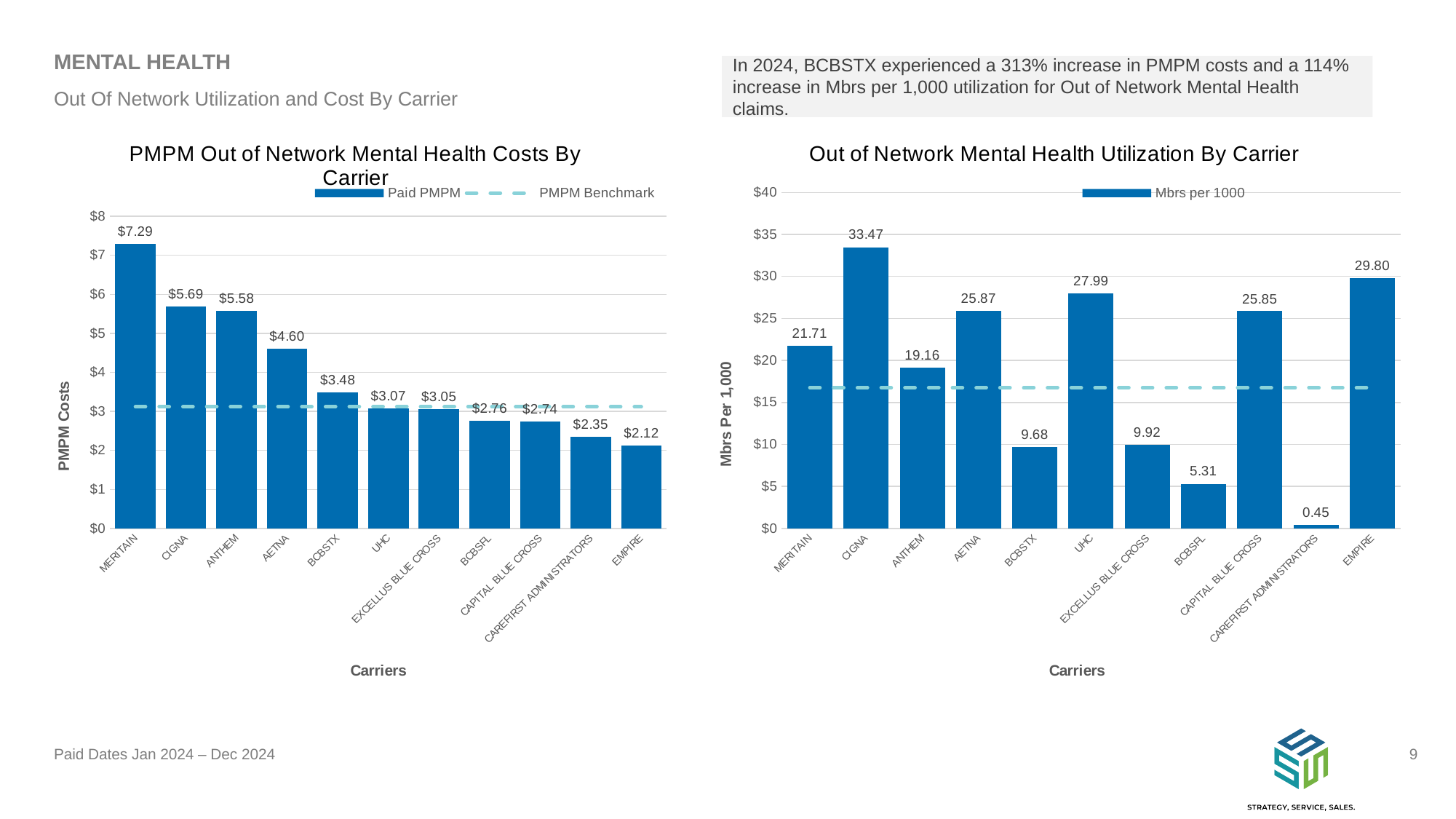
In the Out of Network Mental Health Utilization By Carrier chart, what is the Mbrs per 1000 value for UHC? 27.99 In the PMPM Out of Network Mental Health Costs By Carrier chart, what is the difference between the Paid PMPM for MERITAIN and CIGNA? $1.60 In the PMPM Out of Network Mental Health Costs By Carrier chart, which carrier has the lowest Paid PMPM? EMPIRE In the PMPM Out of Network Mental Health Costs By Carrier chart, which carrier has the highest Paid PMPM? MERITAIN In the PMPM Out of Network Mental Health Costs By Carrier chart, how many series does the legend list? 2 In the PMPM Out of Network Mental Health Costs By Carrier chart, do the Paid PMPM values rise or fall from left to right along the x axis? fall In the PMPM Out of Network Mental Health Costs By Carrier chart, what is the Paid PMPM value for BCBSTX? $3.48 In the Out of Network Mental Health Utilization By Carrier chart, how many carriers are shown on the x axis? 11 What kind of chart is the Out of Network Mental Health Utilization By Carrier chart? combination bar and line chart In the Out of Network Mental Health Utilization By Carrier chart, which carrier has the highest Mbrs per 1000? CIGNA In the Out of Network Mental Health Utilization By Carrier chart, which carrier has the lowest Mbrs per 1000? CAREFIRST ADMINISTRATORS In the Out of Network Mental Health Utilization By Carrier chart, which has a higher Mbrs per 1000 value, EMPIRE or AETNA? EMPIRE